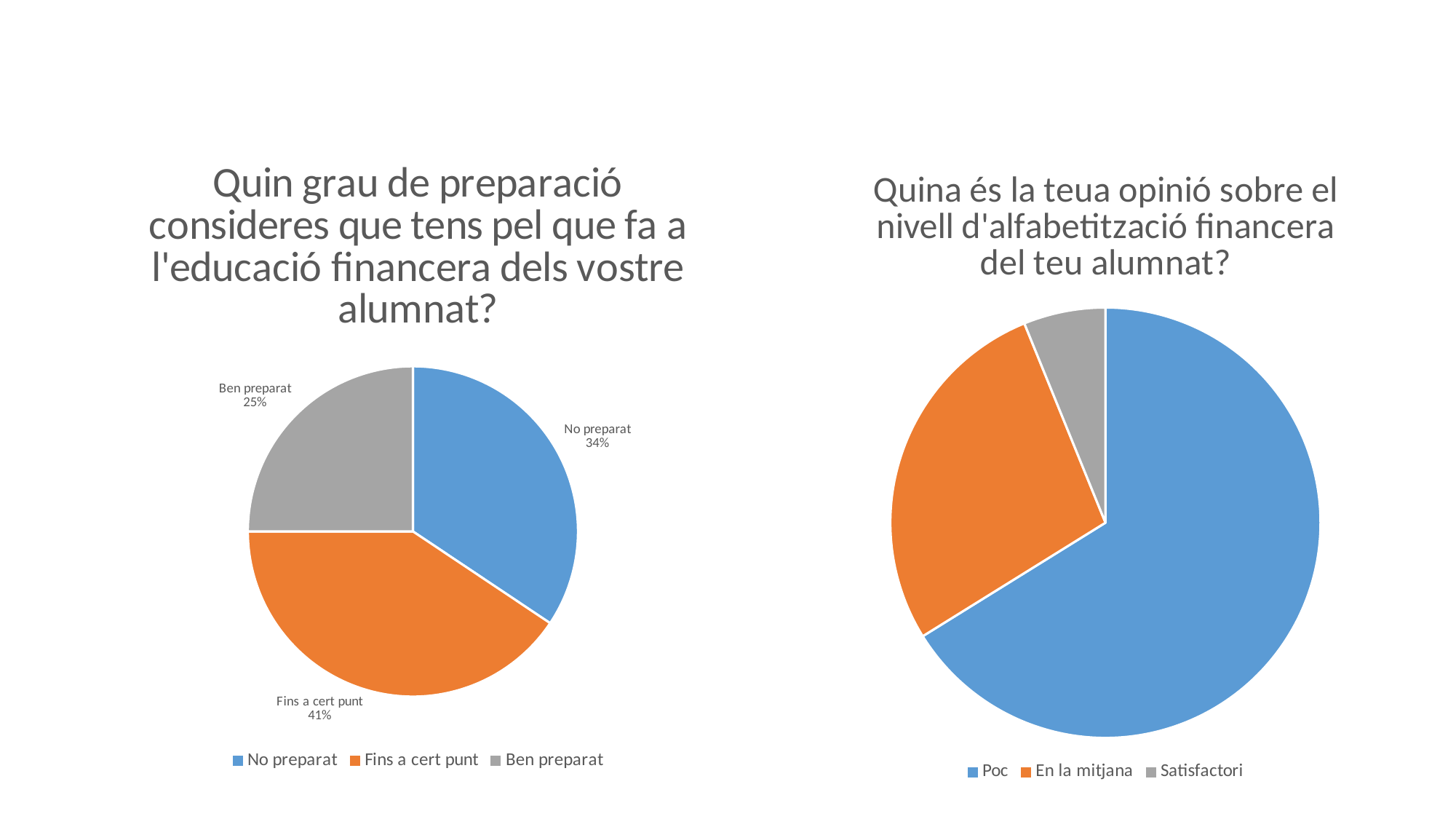
In the left pie chart ("Quin grau de preparació..."), which is larger, "No preparat" or "Ben preparat"? No preparat In the right pie chart ("Quina és la teua opinió..."), which is larger, "En la mitjana" or "Satisfactori"? En la mitjana In the left pie chart ("Quin grau de preparació..."), which category has the smallest slice? Ben preparat In the right pie chart ("Quina és la teua opinió..."), which category has the smallest slice? Satisfactori In the left pie chart ("Quin grau de preparació..."), which category has the largest slice? Fins a cert punt In the right pie chart ("Quina és la teua opinió..."), which category has the largest slice? Poc What type of chart is the left chart ("Quin grau de preparació...")? Pie chart In the left pie chart ("Quin grau de preparació..."), what percentage is shown for "Ben preparat"? 25% In the left pie chart ("Quin grau de preparació..."), what share of the pie does "No preparat" take? 34% How many categories does the legend of the right pie chart ("Quina és la teua opinió...") list? 3 In the left pie chart ("Quin grau de preparació..."), what percentage is shown for "Fins a cert punt"? 41% In the left pie chart ("Quin grau de preparació..."), what is the difference in percentage points between "Fins a cert punt" and "No preparat"? 7